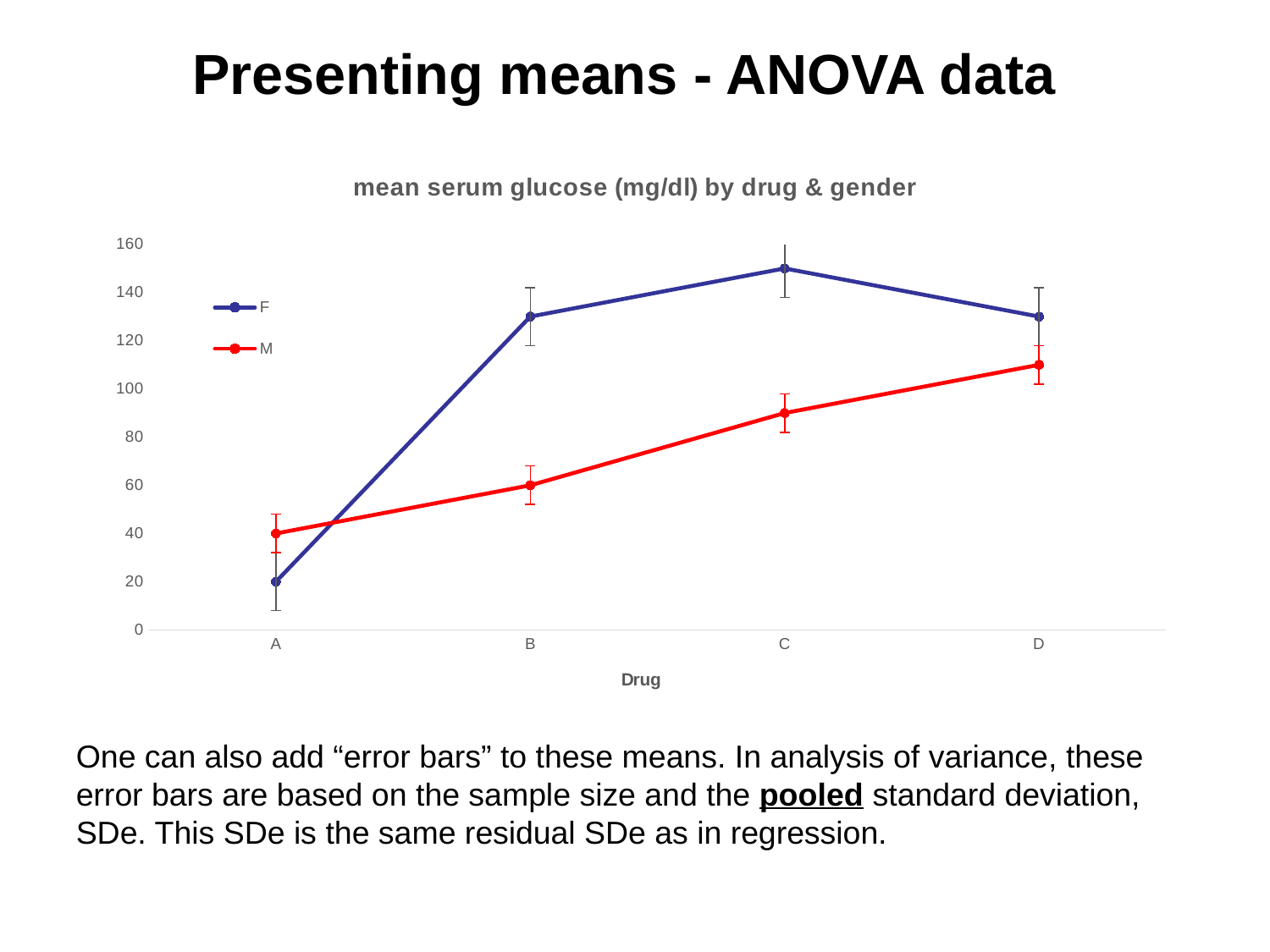
What kind of chart is shown on the slide? line chart For which drug is the value of series M highest? D At drug B, which series has the larger value, F or M? F Is the value for series F at drug C greater or less than 140? greater How many drug categories are shown on the x axis? 4 What is the value for series M at drug A? 40 Do the values for series M rise or fall from drug A to drug D? rise What is the value for series M at drug B? 60 How many series does the legend list? 2 Is the value for series M at drug C greater or less than 100? less For which drug is the value of series F highest? C What is the value for series F at drug A? 20